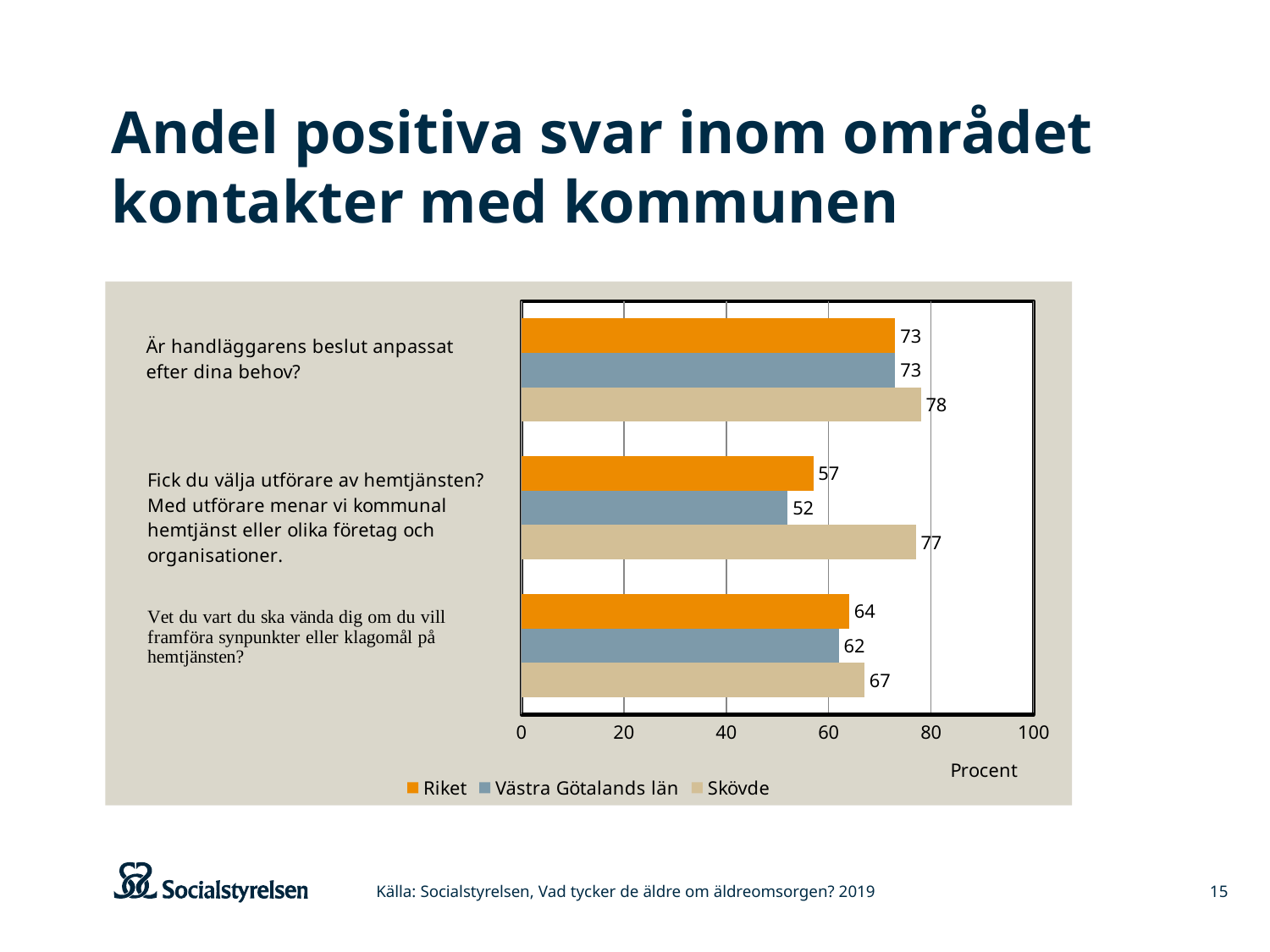
What is the value for Riket on the question "Är handläggarens beslut anpassat efter dina behov?"? 73 Which series has the lowest value on the question "Fick du välja utförare av hemtjänsten?"? Västra Götalands län What unit is shown on the horizontal axis of the chart? Procent What is the value for Västra Götalands län on the question "Vet du vart du ska vända dig om du vill framföra synpunkter eller klagomål på hemtjänsten?"? 62 What is the value for Skövde on the question "Fick du välja utförare av hemtjänsten?"? 77 Which series has the highest value on the question "Är handläggarens beslut anpassat efter dina behov?"? Skövde What is the difference between Skövde and Västra Götalands län on the question "Fick du välja utförare av hemtjänsten?"? 25 What kind of chart is shown on the slide? Bar chart Which is larger on the question "Vet du vart du ska vända dig om du vill framföra synpunkter eller klagomål på hemtjänsten?": Riket or Skövde? Skövde How many series does the legend list? 3 How many questions (categories) are shown on the chart? 3 Which colour represents Riket in the legend? Orange